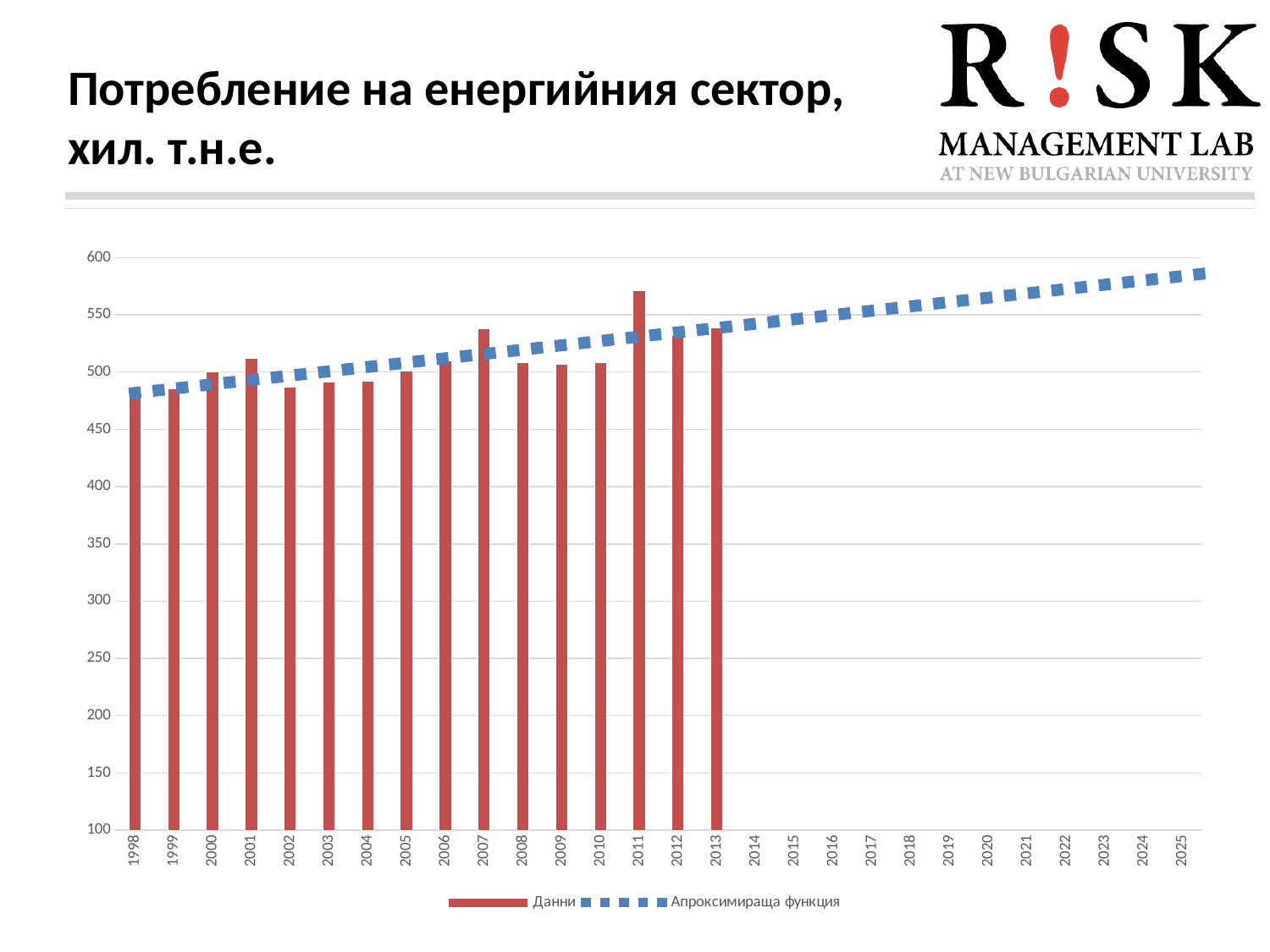
Is the value for 2004 greater or less than 500? less Is the value for 2007 greater or less than 500? greater Is the value for 2011 greater or less than 550? greater What kind of chart is shown on the slide? Bar chart with a dotted trend line Which year has the highest bar? 2011 How many series does the legend list? 2 What are the two entries in the legend? Данни and Апроксимираща функция Which is larger, the bar for 2011 or the bar for 2000? 2011 What is the last year shown on the x axis? 2025 Does the dotted approximating line rise or fall from 1998 to 2025? rises How many years have a red bar plotted? 16